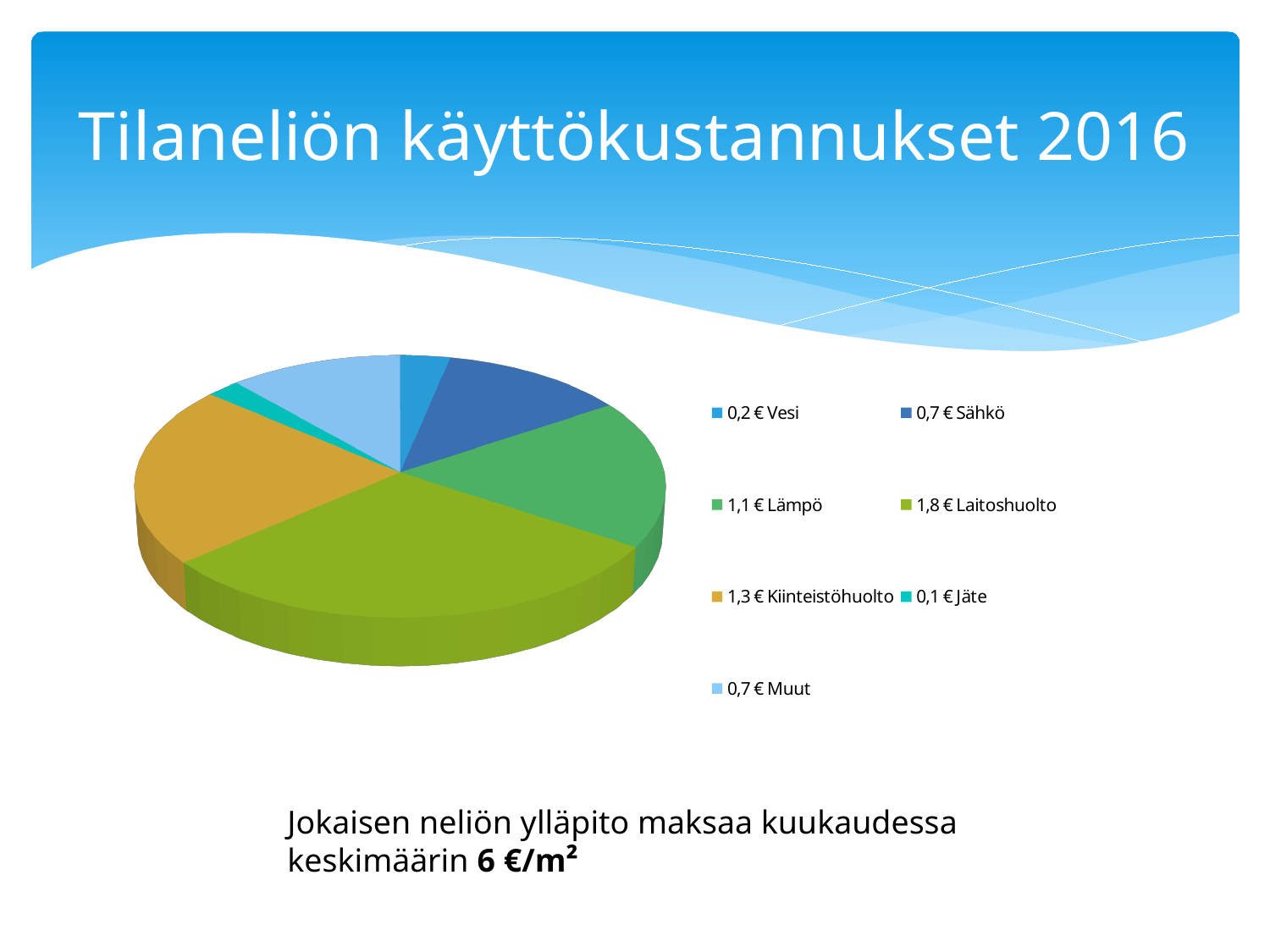
What is the value for Laitoshuolto? 1,8 € What is the difference between the values for Sähkö and Vesi? 0,5 € Which is larger, the value for Lämpö or the value for Kiinteistöhuolto? Kiinteistöhuolto Which category has the highest value? Laitoshuolto What is the title of the slide containing the chart? Tilaneliön käyttökustannukset 2016 What is the value for Kiinteistöhuolto? 1,3 € Which category has the lowest value? Jäte How many categories does the pie chart have? 7 What kind of chart is shown on the slide? Pie chart What is the value for Vesi? 0,2 € What is the value for Lämpö? 1,1 € What is the difference between the values for Laitoshuolto and Kiinteistöhuolto? 0,5 €